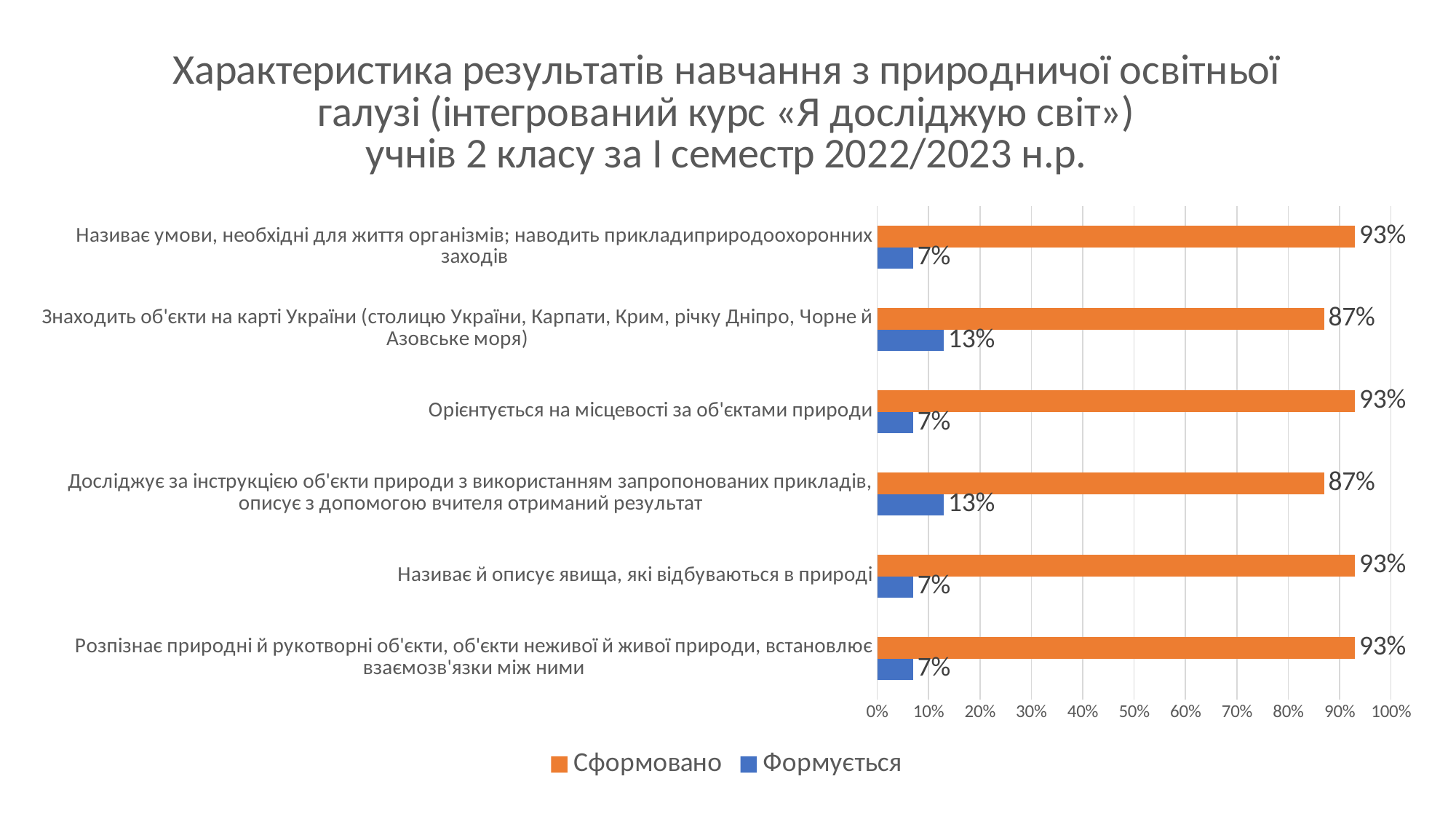
What is the value of Формується for "Досліджує за інструкцією об'єкти природи з використанням запропонованих прикладів, описує з допомогою вчителя отриманий результат"? 13% What kind of chart is shown on the slide? bar chart What is the total of Сформовано and Формується for "Розпізнає природні й рукотворні об'єкти, об'єкти неживої й живої природи, встановлює взаємозв'язки між ними"? 100% How many series does the legend list? 2 Which is larger: the Сформовано value for "Орієнтується на місцевості за об'єктами природи" or for "Знаходить об'єкти на карті України"? Орієнтується на місцевості за об'єктами природи What is the lowest Сформовано value shown on the chart? 87% What is the value of Формується for "Орієнтується на місцевості за об'єктами природи"? 7% How many categories are plotted on the chart? 6 What is the difference between the Формується values for "Знаходить об'єкти на карті України" and "Називає й описує явища, які відбуваються в природі"? 6% Which colour represents the Формується series in the legend? blue What is the value of Сформовано for "Називає й описує явища, які відбуваються в природі"? 93% What is the value of Сформовано for "Знаходить об'єкти на карті України (столицю України, Карпати, Крим, річку Дніпро, Чорне й Азовське моря)"? 87%